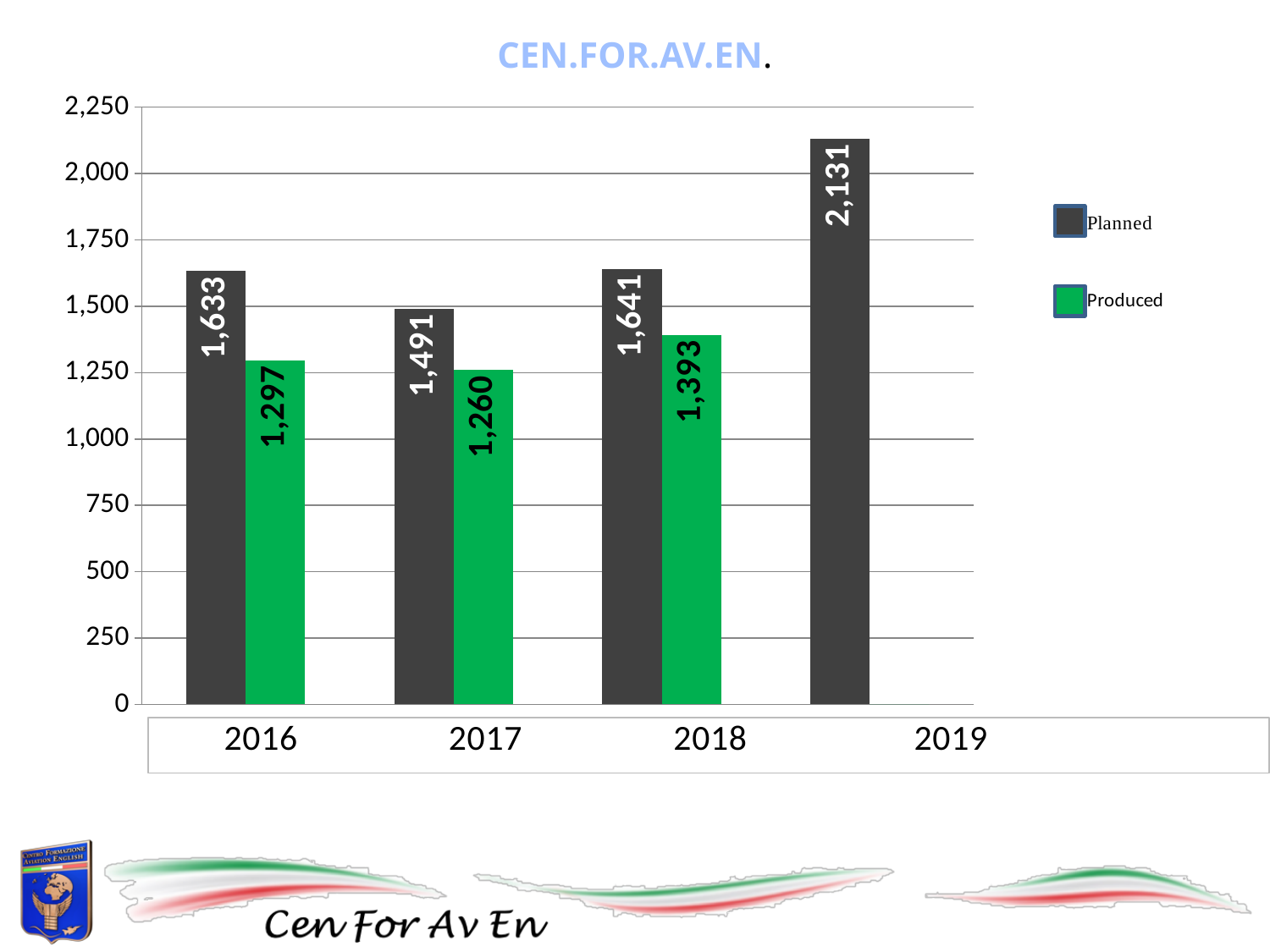
What kind of chart is shown on the slide? Bar chart What is the difference between the Planned values for 2019 and 2018? 490 Which year has the highest Planned value? 2019 What is the Produced value for 2017? 1,260 What colour are the Produced bars? Green What is the Planned value for 2019? 2,131 Which is larger, the Produced value for 2016 or the Produced value for 2018? Produced value for 2018 How many series does the legend list? 2 What is the difference between Planned and Produced in 2016? 336 What is the Planned value for 2016? 1,633 What is the Produced value for 2018? 1,393